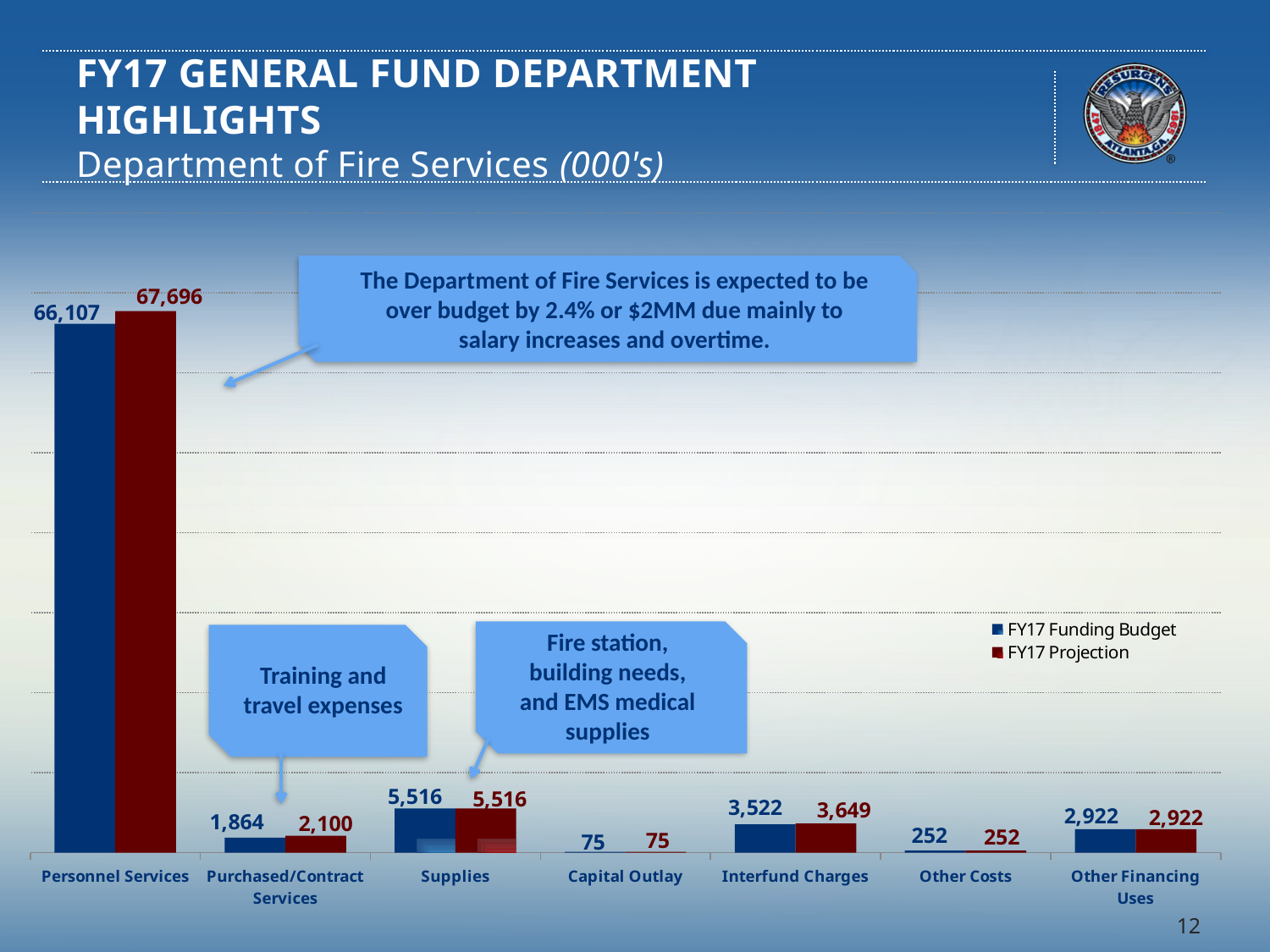
What is the FY17 Projection value for Purchased/Contract Services? 2,100 What is the difference between the FY17 Projection and the FY17 Funding Budget for Personnel Services? 1,589 How many series does the legend list? 2 Which colour represents the FY17 Projection series in the legend? Red Which category has the highest FY17 Projection value? Personnel Services What is the FY17 Funding Budget value for Personnel Services? 66,107 Which is larger for Interfund Charges, the FY17 Funding Budget or the FY17 Projection? FY17 Projection How many categories are shown on the x axis of the chart? 7 Which category has the lowest FY17 Funding Budget value? Capital Outlay What kind of chart is shown on the slide? Bar chart What is the FY17 Projection value for Interfund Charges? 3,649 What is the difference between the FY17 Projection and the FY17 Funding Budget for Purchased/Contract Services? 236